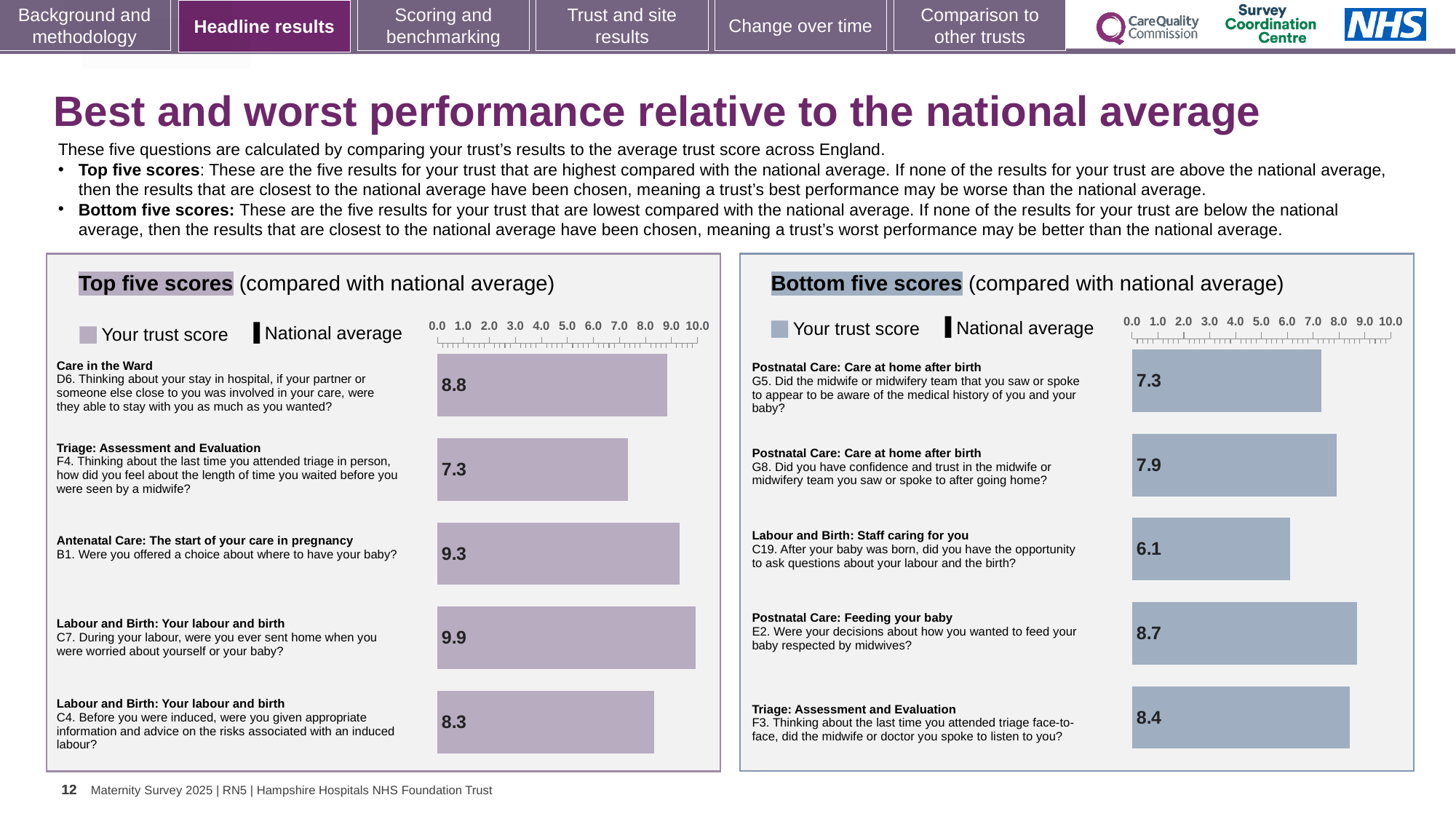
In the Top five scores chart, what is the trust score for question C7 (Labour and Birth: Your labour and birth)? 9.9 In the Bottom five scores chart, which has the larger trust score, G8 or F3? F3 How many bars are shown in the Bottom five scores chart? 5 In the Top five scores chart, what is the difference between the trust scores for C7 and F4? 2.6 In the Top five scores chart, which question has the highest trust score? C7 In the Top five scores chart, what is the trust score for question D6 (Care in the Ward)? 8.8 In the Bottom five scores chart, which question has the highest trust score? E2 In the Bottom five scores chart, which question has the lowest trust score? C19 In the Top five scores chart, which question has the lowest trust score? F4 In the Bottom five scores chart, what is the trust score for question C19 (Labour and Birth: Staff caring for you)? 6.1 In the Bottom five scores chart, what is the trust score for question E2 (Postnatal Care: Feeding your baby)? 8.7 What type of chart is used in the Top five scores panel? Bar chart